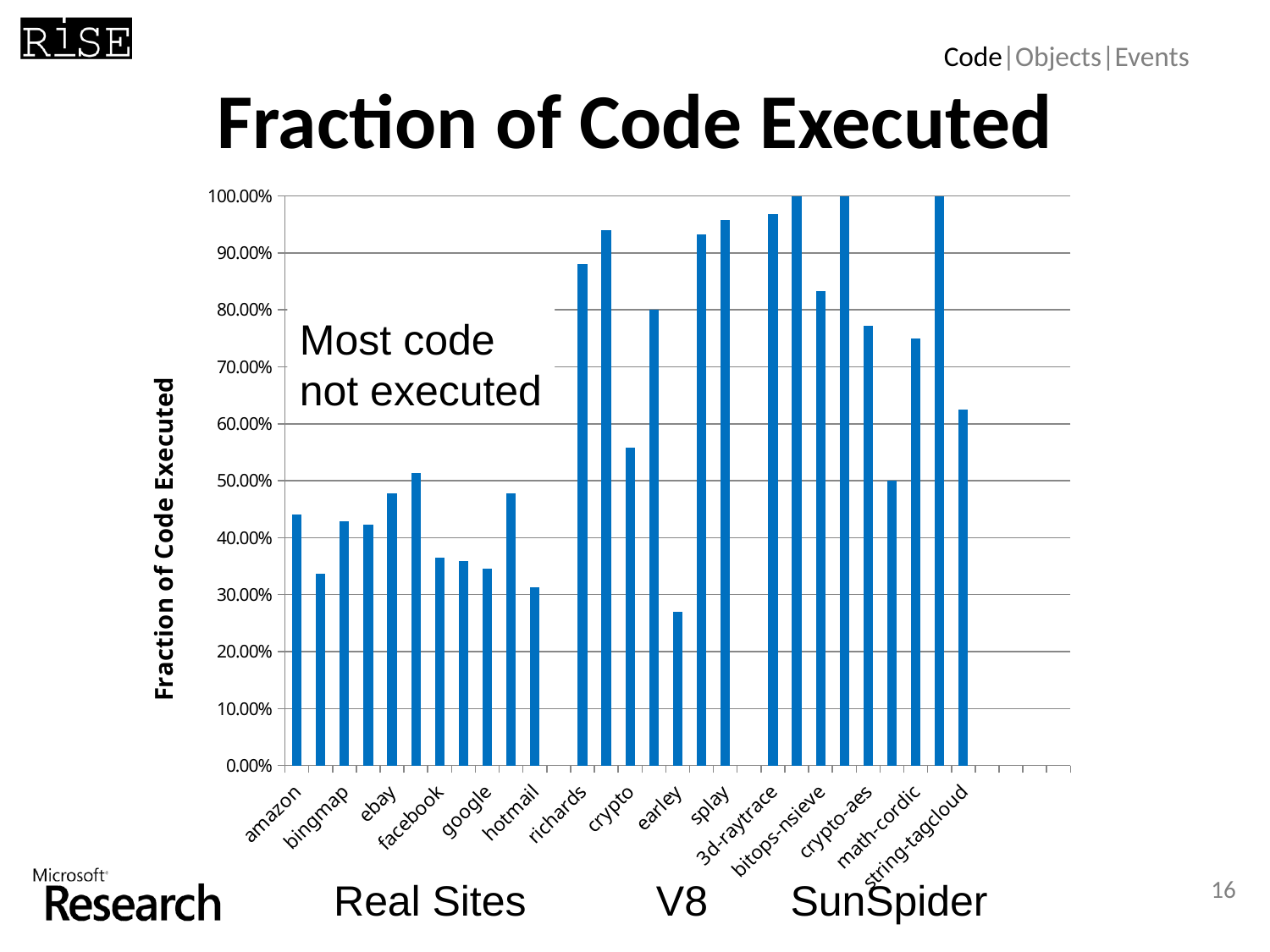
Is the value for amazon greater or less than 40.00%? greater What is the label on the vertical axis? Fraction of Code Executed Is the value for hotmail greater or less than 40.00%? less What kind of chart is shown on the slide? bar chart Which has a higher value, amazon or hotmail? amazon Is the value for splay greater or less than 90.00%? greater What is the title of the chart? Fraction of Code Executed Which has a higher value, 3d-raytrace or math-cordic? 3d-raytrace Which has a higher value, richards or crypto? richards